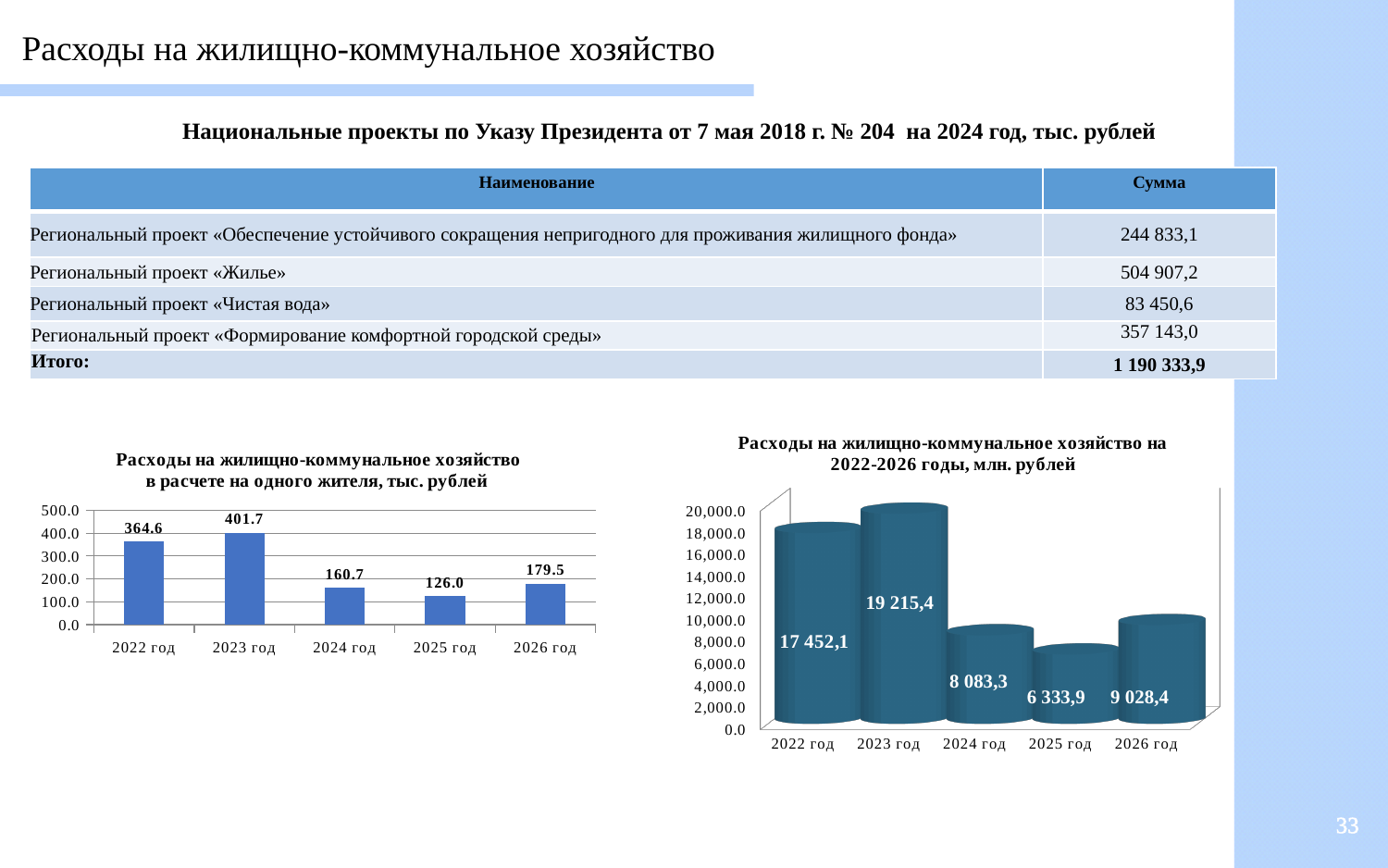
In the left chart (per-resident expenses, thousand rubles), what is the value for 2023 год? 401.7 In the left chart (per-resident expenses, thousand rubles), which year has the lowest value? 2025 год In the right chart (expenses for 2022-2026, million rubles), what is the value for 2026 год? 9 028,4 In the left chart (per-resident expenses, thousand rubles), how many years are shown on the x axis? 5 In the right chart (expenses for 2022-2026, million rubles), which is larger: the value for 2024 год or the value for 2026 год? 2026 год What kind of chart is the right chart (expenses for 2022-2026, million rubles)? bar chart In the left chart (per-resident expenses, thousand rubles), what is the value for 2025 год? 126.0 In the right chart (expenses for 2022-2026, million rubles), which year has the lowest value? 2025 год In the left chart (per-resident expenses, thousand rubles), what is the difference between the values for 2022 год and 2024 год? 203.9 In the right chart (expenses for 2022-2026, million rubles), which year has the highest value? 2023 год In the right chart (expenses for 2022-2026, million rubles), what is the value for 2022 год? 17 452,1 In the left chart (per-resident expenses, thousand rubles), which year has the highest value? 2023 год